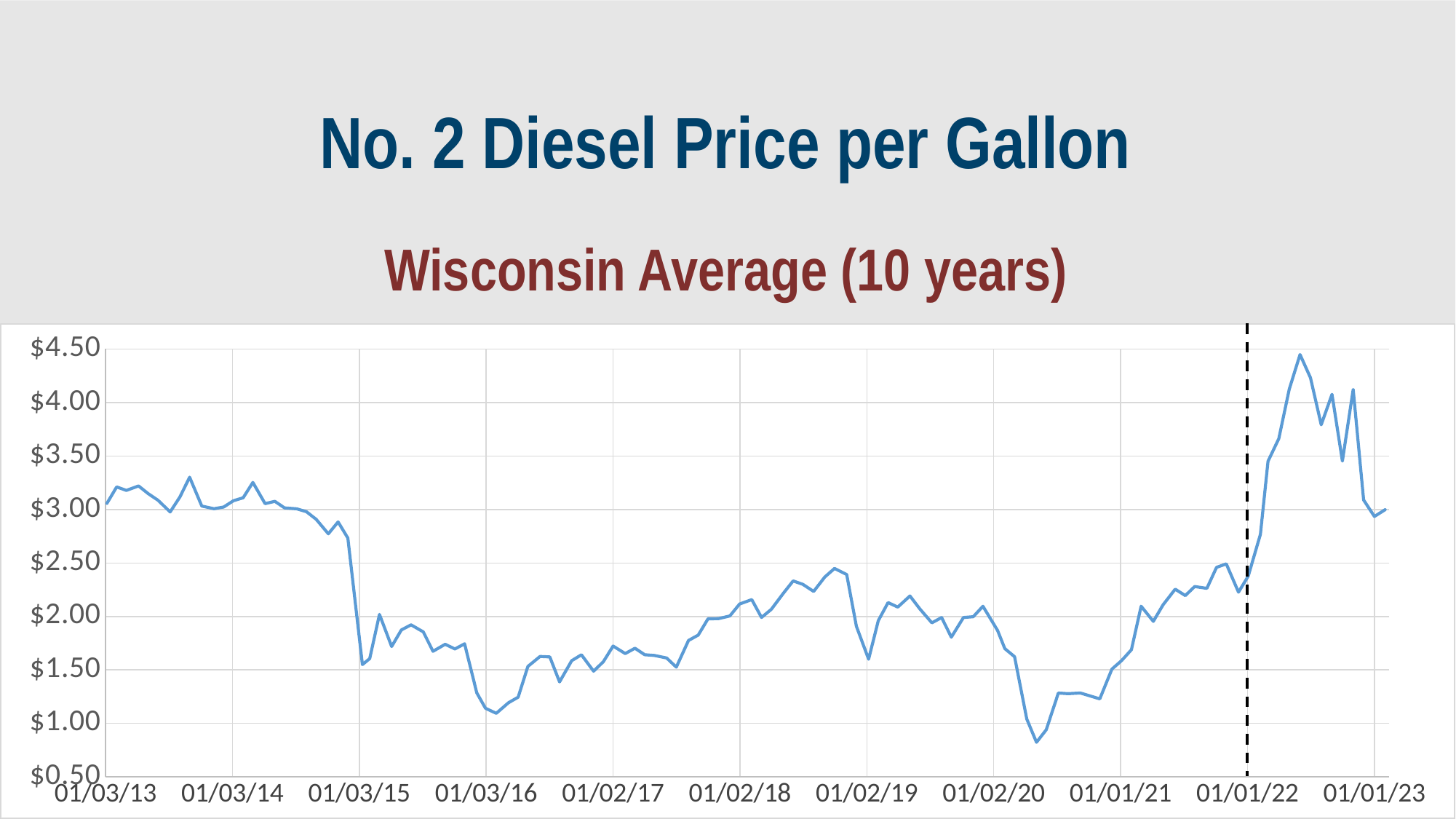
How many date labels are shown along the x axis? 11 What kind of chart is shown on the slide? line chart Which is larger, the value at 01/03/13 or the value at 01/03/16? 01/03/13 Is the value at 01/01/23 greater or less than $2.50? greater Is the value at 01/03/15 greater or less than $2.50? less What subtitle appears below the chart title? Wisconsin Average (10 years) Is the value at 01/03/13 greater or less than $2.50? greater What is the title of the chart on the slide? No. 2 Diesel Price per Gallon In which year does the line reach its highest point? 2022 Does the line rise or fall between 01/01/21 and 01/01/22? rise